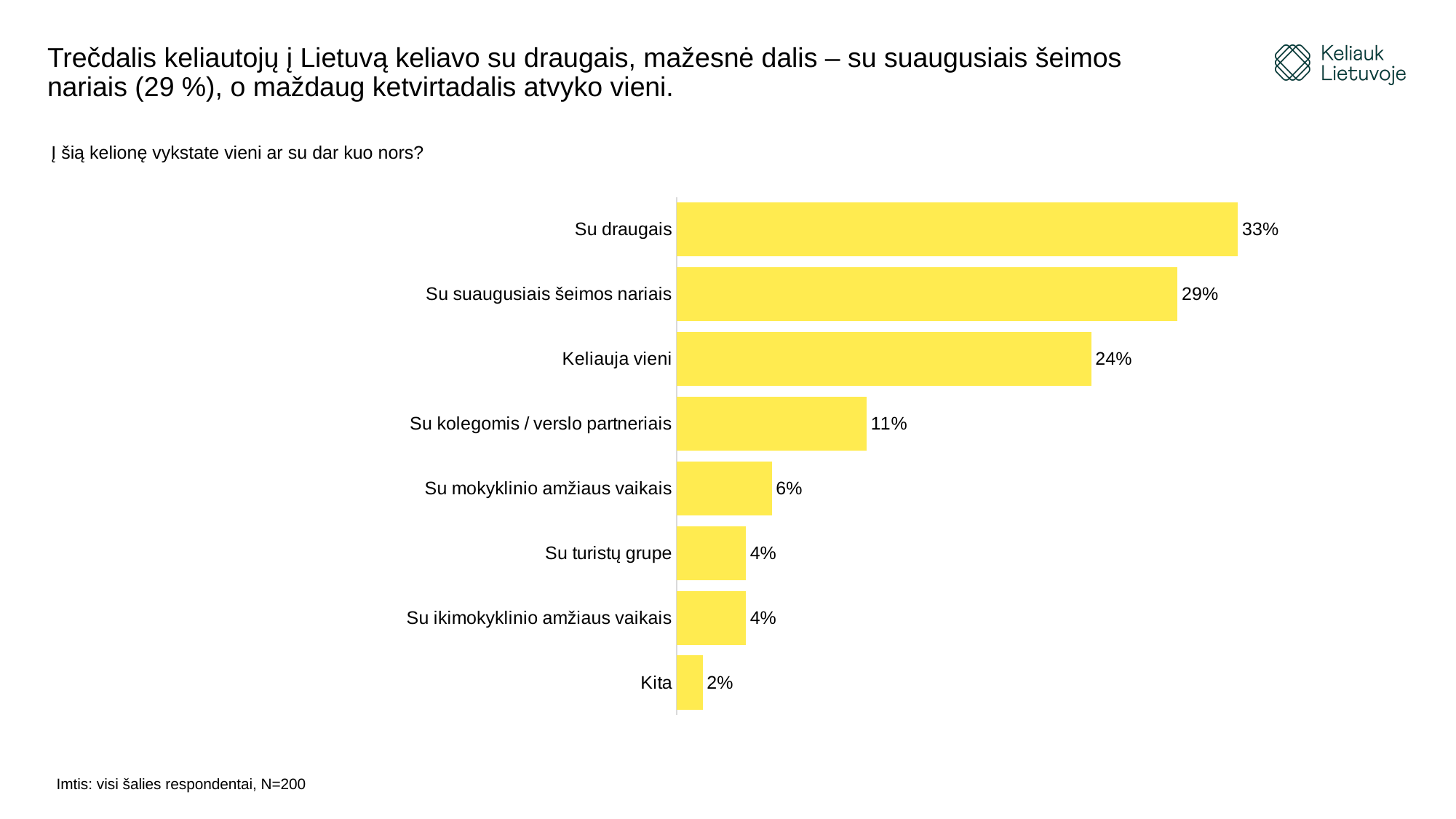
What kind of chart is shown on the slide? Bar chart What is the difference between 'Keliauja vieni' and 'Su kolegomis / verslo partneriais'? 13 percentage points Which is larger: 'Su mokyklinio amžiaus vaikais' or 'Su turistų grupe'? Su mokyklinio amžiaus vaikais What is the value for 'Keliauja vieni'? 24% What percentage of respondents travel with friends (Su draugais)? 33% Which category has the highest value? Su draugais What percentage travel with colleagues / business partners (Su kolegomis / verslo partneriais)? 11% What is the sample size stated at the bottom of the slide? N=200 What is the value for 'Kita'? 2% How many categories are shown in the chart? 8 What is the difference between 'Su draugais' and 'Su suaugusiais šeimos nariais'? 4 percentage points Which category has the lowest value? Kita